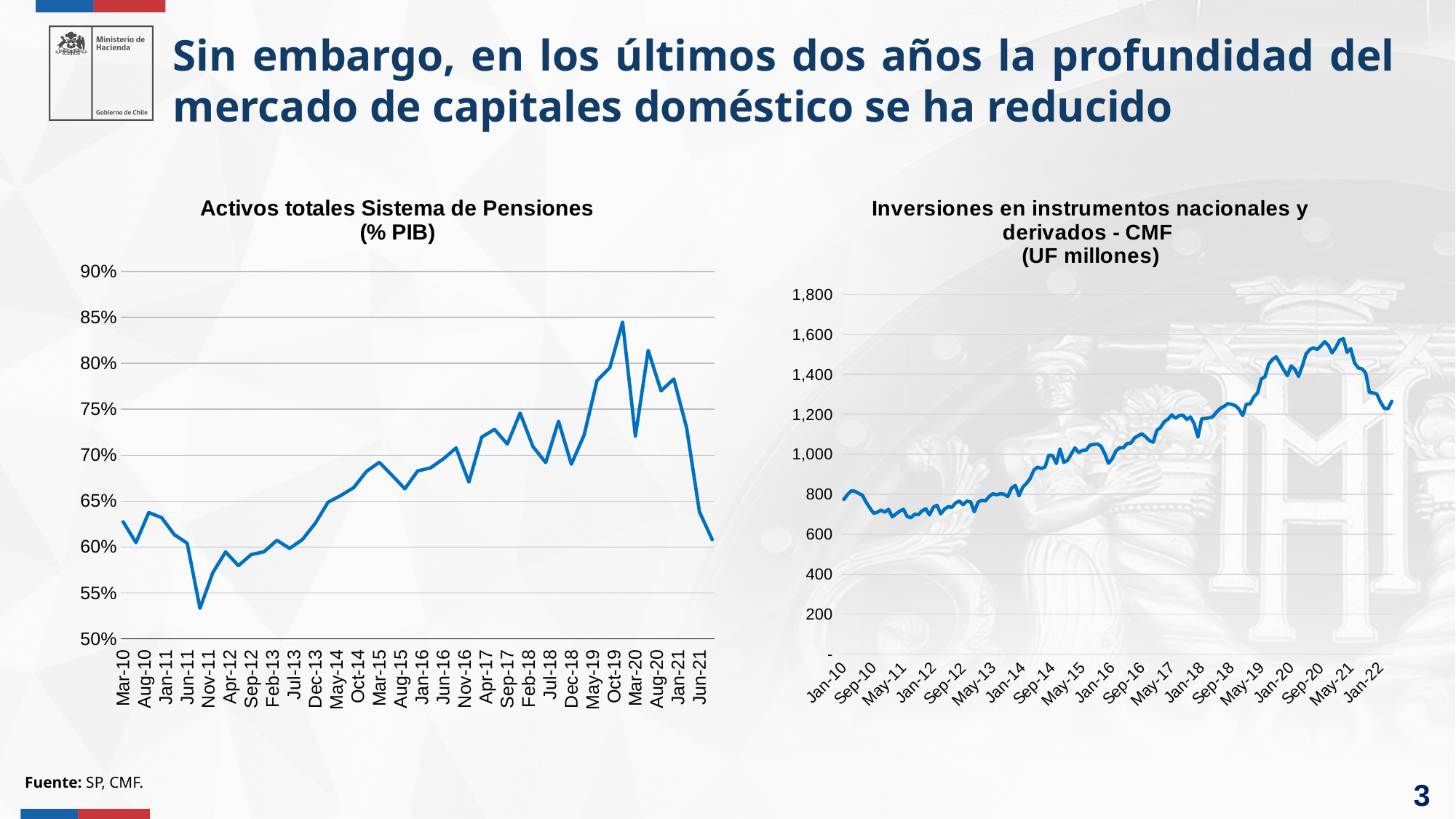
In the left chart (Activos totales Sistema de Pensiones), does the line rise or fall between Jan-21 and Jun-21? fall What kind of chart is the 'Inversiones en instrumentos nacionales y derivados - CMF' chart on the right? line chart In the right chart (Inversiones en instrumentos nacionales y derivados - CMF), is the value at May-21 greater or less than 1,400? greater In the right chart (Inversiones en instrumentos nacionales y derivados - CMF), is the value at Jan-22 greater or less than 1,000? greater In the left chart (Activos totales Sistema de Pensiones), is the value at Jun-21 greater or less than 65%? less What unit is shown in the title of the right chart (Inversiones en instrumentos nacionales y derivados - CMF)? UF millones What kind of chart is the 'Activos totales Sistema de Pensiones (% PIB)' chart on the left? line chart In the right chart (Inversiones en instrumentos nacionales y derivados - CMF), does the line overall rise or fall between Jan-10 and May-21? rise In the left chart (Activos totales Sistema de Pensiones), does the line overall rise or fall between Mar-10 and Oct-19? rise